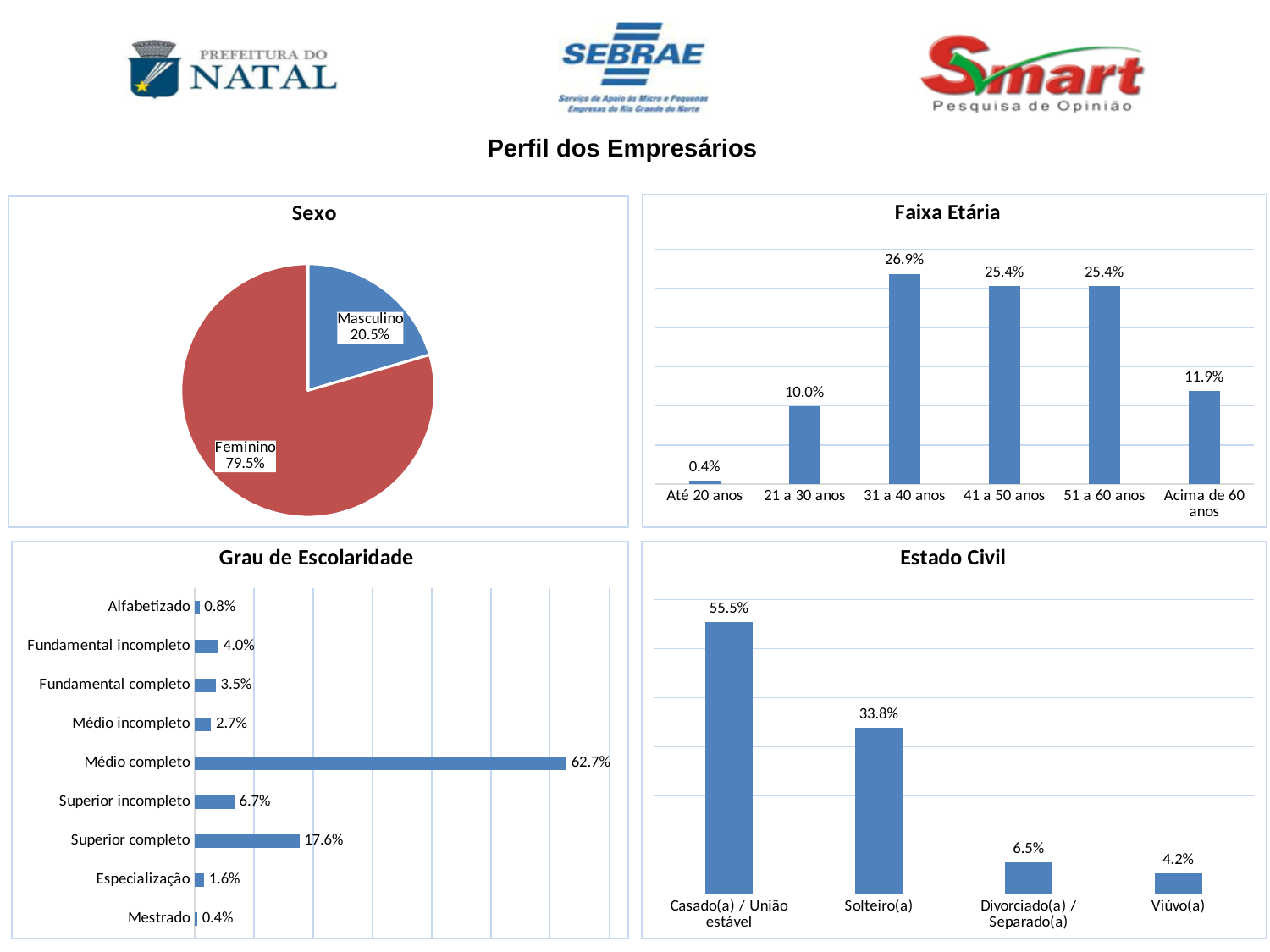
In the 'Grau de Escolaridade' chart, what is the value for Superior completo? 17.6% In the 'Sexo' chart, what kind of chart is shown? pie chart In the 'Faixa Etária' chart, how many age groups are shown? 6 In the 'Faixa Etária' chart, what is the value for 31 a 40 anos? 26.9% In the 'Faixa Etária' chart, what is the difference between 31 a 40 anos and Acima de 60 anos? 15.0% In the 'Grau de Escolaridade' chart, which is larger: Fundamental incompleto or Fundamental completo? Fundamental incompleto In the 'Faixa Etária' chart, which age group has the lowest value? Até 20 anos In the 'Estado Civil' chart, what is the value for Solteiro(a)? 33.8% In the 'Grau de Escolaridade' chart, how many categories are listed? 9 In the 'Estado Civil' chart, what is the difference between Casado(a) / União estável and Solteiro(a)? 21.7% In the 'Grau de Escolaridade' chart, which category has the highest value? Médio completo In the 'Sexo' chart, what share is Feminino? 79.5%